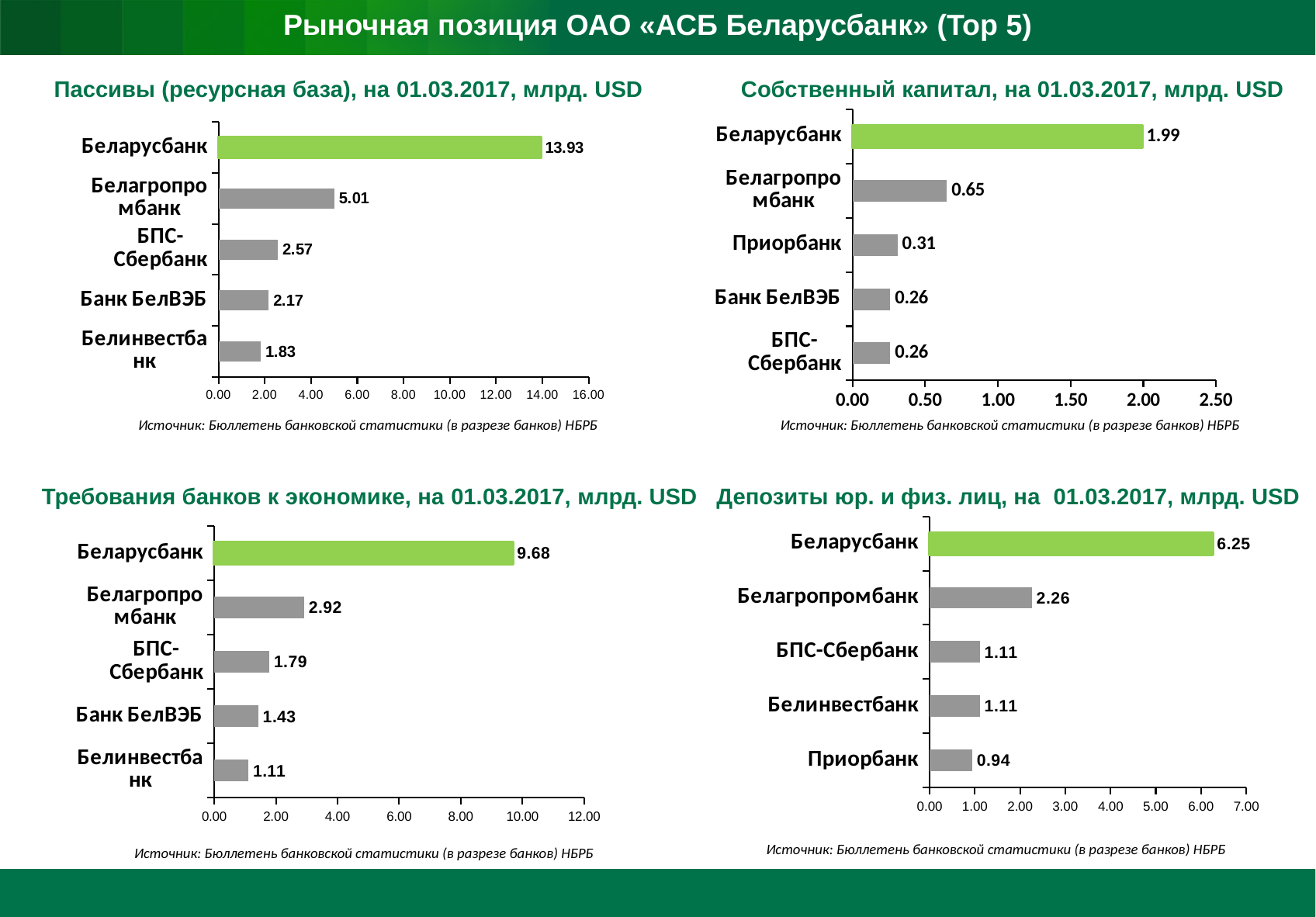
In the chart 'Пассивы (ресурсная база), на 01.03.2017, млрд. USD', what is the value for Беларусбанк? 13.93 In the chart 'Собственный капитал, на 01.03.2017, млрд. USD', what is the value for Приорбанк? 0.31 In the chart 'Депозиты юр. и физ. лиц, на 01.03.2017, млрд. USD', is the value for Беларусбанк greater or less than 6.00? greater In the chart 'Депозиты юр. и физ. лиц, на 01.03.2017, млрд. USD', what is the value for Приорбанк? 0.94 In the chart 'Требования банков к экономике, на 01.03.2017, млрд. USD', what is the value for Банк БелВЭБ? 1.43 In the chart 'Пассивы (ресурсная база), на 01.03.2017, млрд. USD', which bank has the lowest value? Белинвестбанк In the chart 'Собственный капитал, на 01.03.2017, млрд. USD', what is the difference between Беларусбанк and Белагропромбанк? 1.34 In the chart 'Пассивы (ресурсная база), на 01.03.2017, млрд. USD', what is the difference between Беларусбанк and Белагропромбанк? 8.92 What type of chart is 'Собственный капитал, на 01.03.2017, млрд. USD'? Bar chart How many banks are shown in the chart 'Требования банков к экономике, на 01.03.2017, млрд. USD'? 5 In the chart 'Депозиты юр. и физ. лиц, на 01.03.2017, млрд. USD', which bank has the highest value? Беларусбанк In the chart 'Требования банков к экономике, на 01.03.2017, млрд. USD', which is larger: БПС-Сбербанк or Белинвестбанк? БПС-Сбербанк